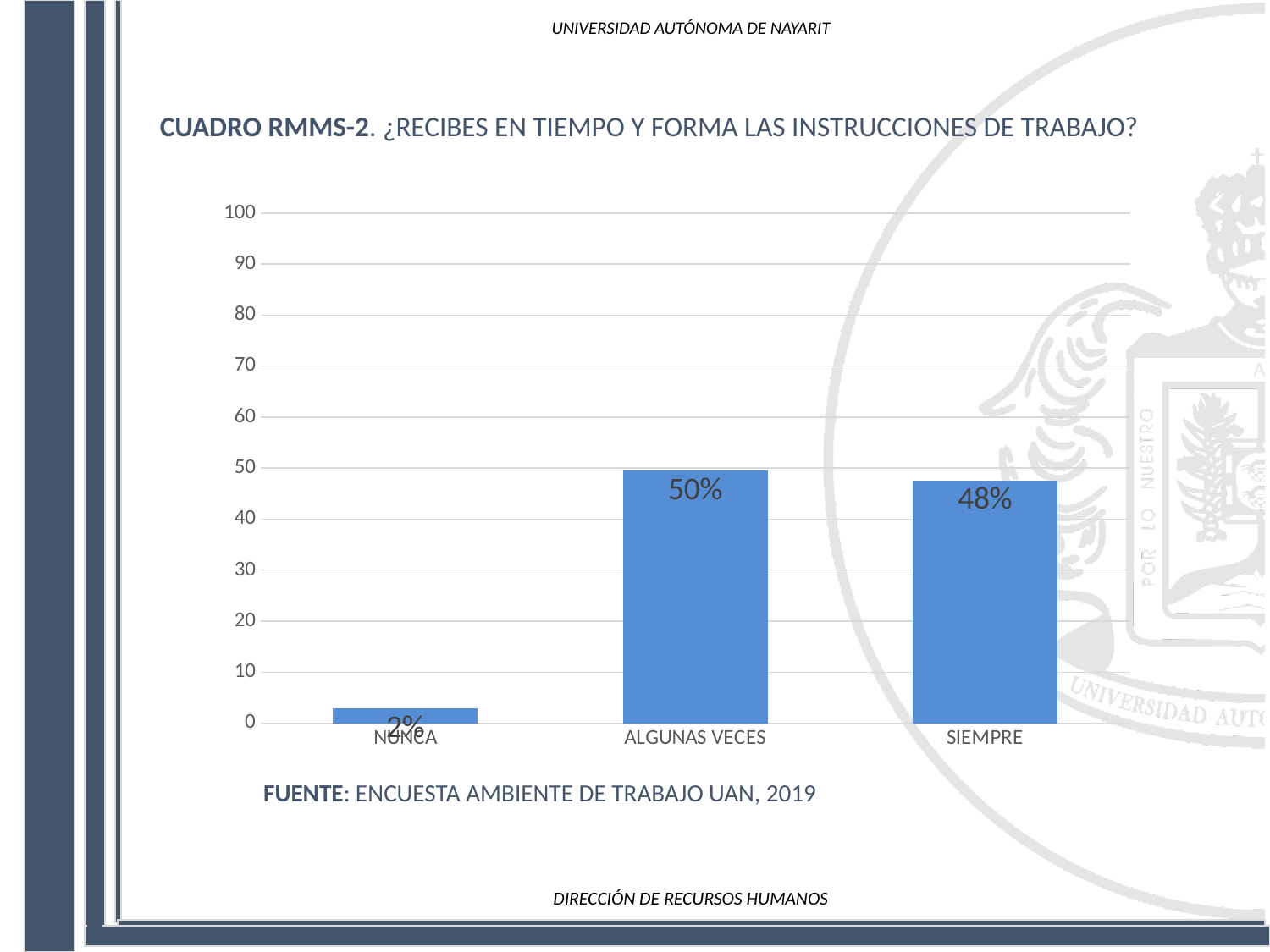
What is the value for NUNCA? 2% What source is cited below the chart? ENCUESTA AMBIENTE DE TRABAJO UAN, 2019 How many categories are shown on the x axis? 3 What kind of chart is shown on the slide? bar chart What is the difference between the values for SIEMPRE and NUNCA? 46% Which category has the highest value? ALGUNAS VECES What is the value for SIEMPRE? 48% Which category has the lowest value? NUNCA Is the value for SIEMPRE greater or less than 40? greater What is the difference between the values for ALGUNAS VECES and SIEMPRE? 2% What is the value for ALGUNAS VECES? 50% Which is larger, the value for SIEMPRE or the value for NUNCA? SIEMPRE